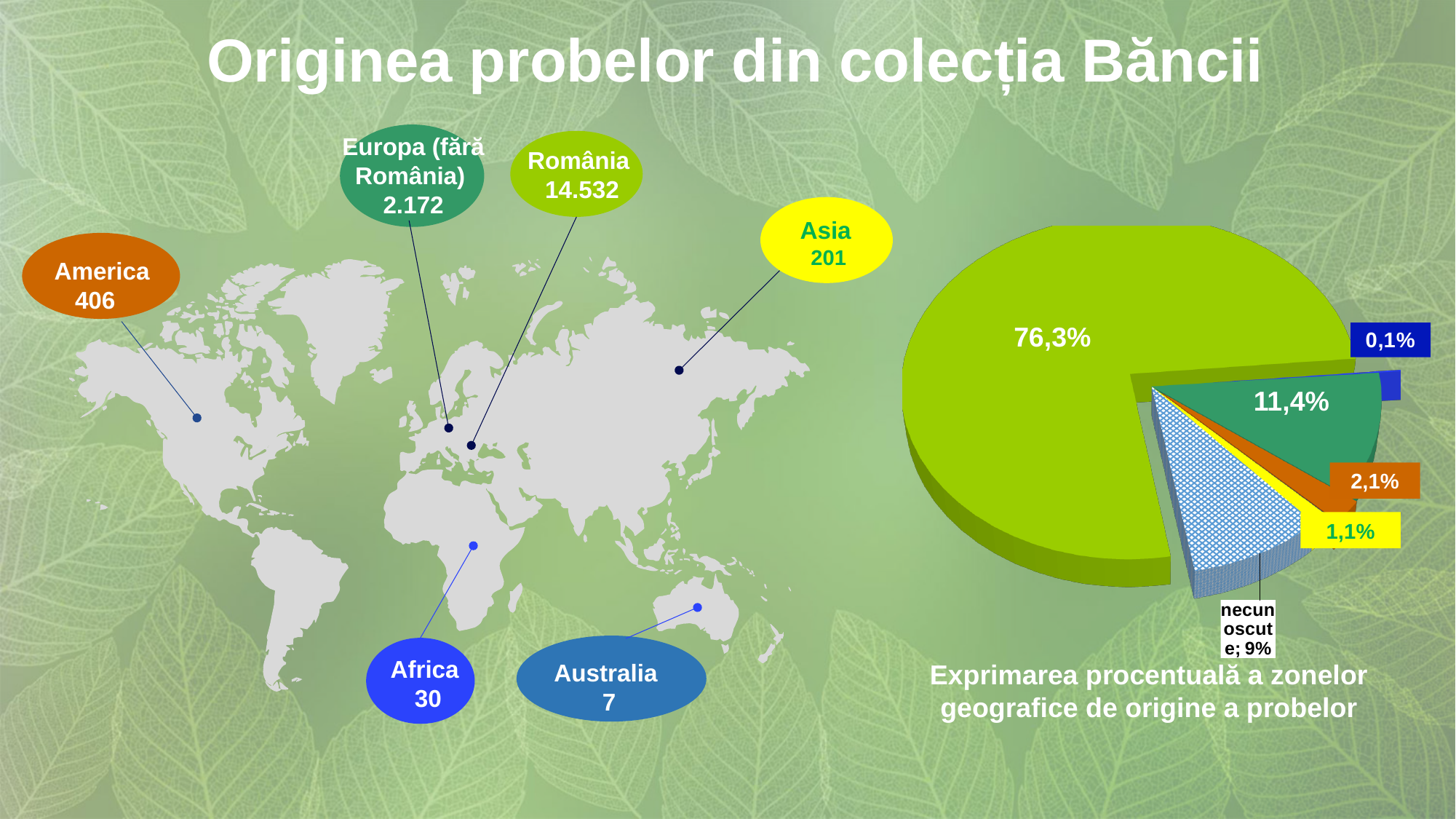
Which is larger in the pie chart: the 0,1% slice or the 1,1% slice? the 1,1% slice What caption is written below the pie chart? Exprimarea procentuală a zonelor geografice de origine a probelor What is the difference between the 2,1% slice and the 1,1% slice in the pie chart? 1,0% What kind of chart is shown on the right side of the slide? pie chart What is the share of the largest slice in the pie chart? 76,3% What colour is the largest slice of the pie chart? green What is the share of the smallest labelled slice in the pie chart? 0,1% Which is larger in the pie chart: the 11,4% slice or the "necunoscute" slice? the 11,4% slice What is the difference between the 76,3% slice and the 11,4% slice in the pie chart? 64,9% What share does the slice labelled "necunoscute" have in the pie chart? 9% Is the largest slice of the pie chart greater or less than 50%? greater How many percentage labels are printed on the pie chart? 6